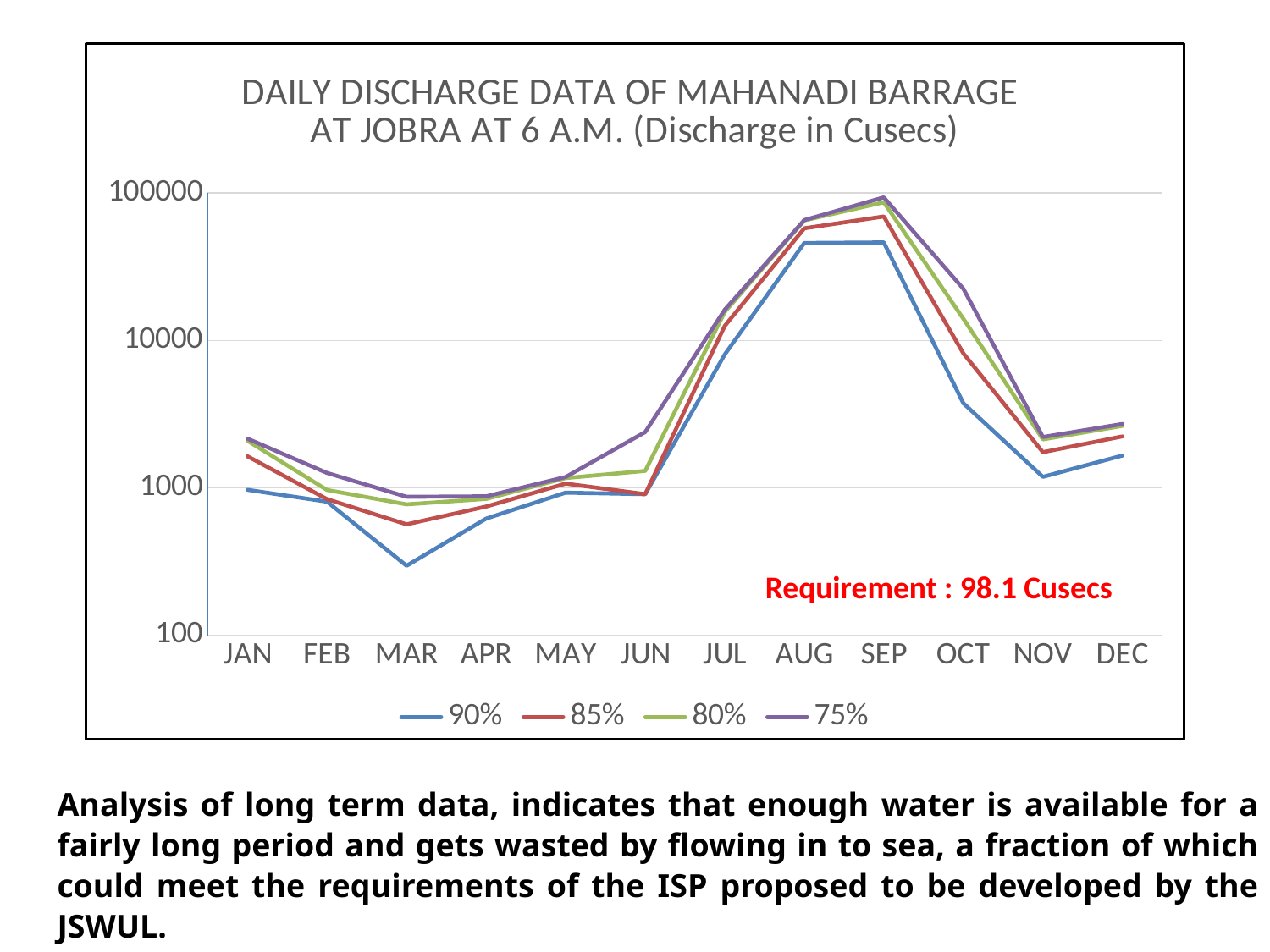
What kind of chart is shown on the slide? line chart In which month does the 90% series reach its lowest value? MAR Is the value for the 90% series in AUG greater or less than 10000? greater Is the value for the 90% series in OCT greater or less than 10000? less Do the values of the 75% series rise or fall from JUN to SEP? rise How many series does the legend list? 4 What requirement value is annotated in red on the chart? 98.1 Cusecs Is the value for the 90% series in MAR greater or less than 1000? less In MAR, which series has the larger value, 90% or 75%? 75% How many months are plotted along the x axis? 12